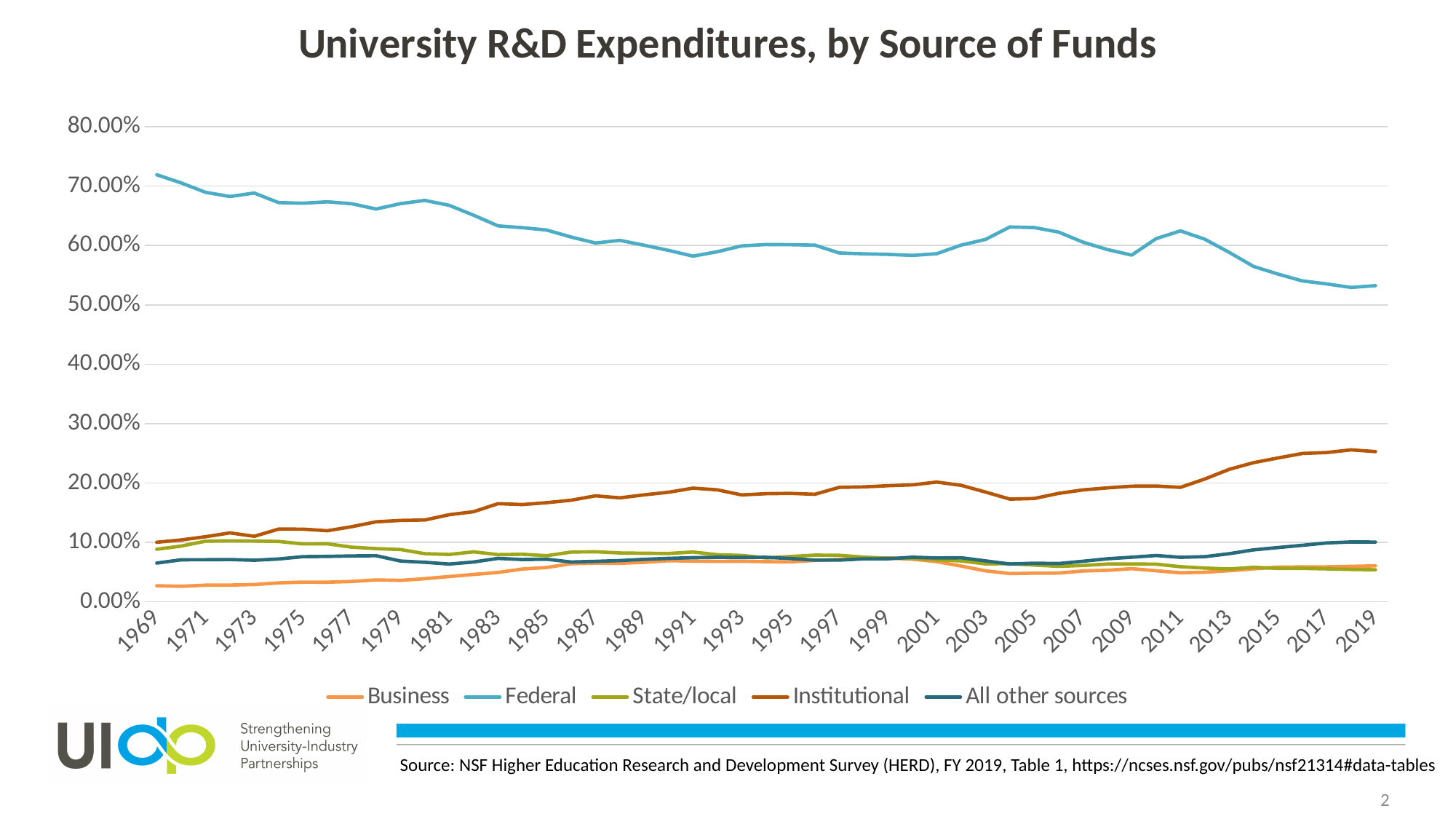
Is the Federal value in 2019 greater or less than 60.00%? less Which source of funds has the lowest share in 1969? Business Is the Institutional value in 2019 greater or less than 20.00%? greater Is the Business value in 1969 greater or less than 10.00%? less In 2019, which is larger, the Federal share or the Institutional share? Federal Does the Federal share rise or fall overall from 1969 to 2019? Fall What kind of chart is shown on the slide? Line chart Does the Institutional share rise or fall overall from 1969 to 2019? Rise How many year labels are shown on the x axis? 26 Which source of funds has the highest share across the whole period shown? Federal How many series does the legend list? 5 What is the title of the chart? University R&D Expenditures, by Source of Funds